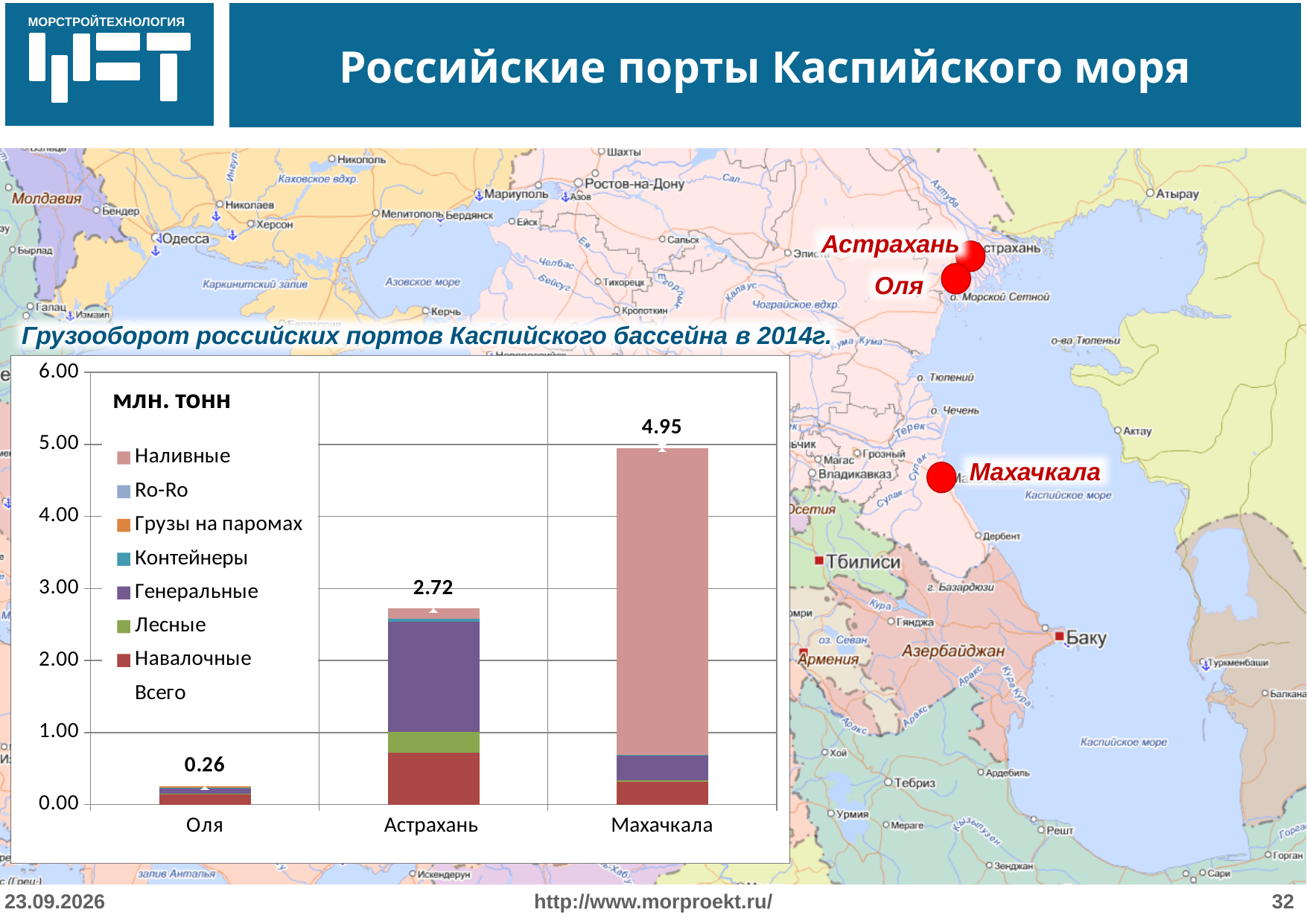
What is the total value labelled above the bar for Астрахань? 2.72 What unit of measurement is stated in the chart? млн. тонн Which is larger, the total for Астрахань or the total for Оля? Астрахань Is the total value for Астрахань greater or less than 2.00? greater What is the difference between the total for Махачкала and the total for Астрахань? 2.23 Which port has the lowest total cargo turnover? Оля What kind of chart is used to show the cargo turnover? Stacked bar chart Which port has the highest total cargo turnover? Махачкала How many ports are shown on the x axis of the chart? 3 How many entries does the chart legend list? 8 What is the total cargo turnover shown for Махачкала? 4.95 What is the total value labelled above the bar for Оля? 0.26